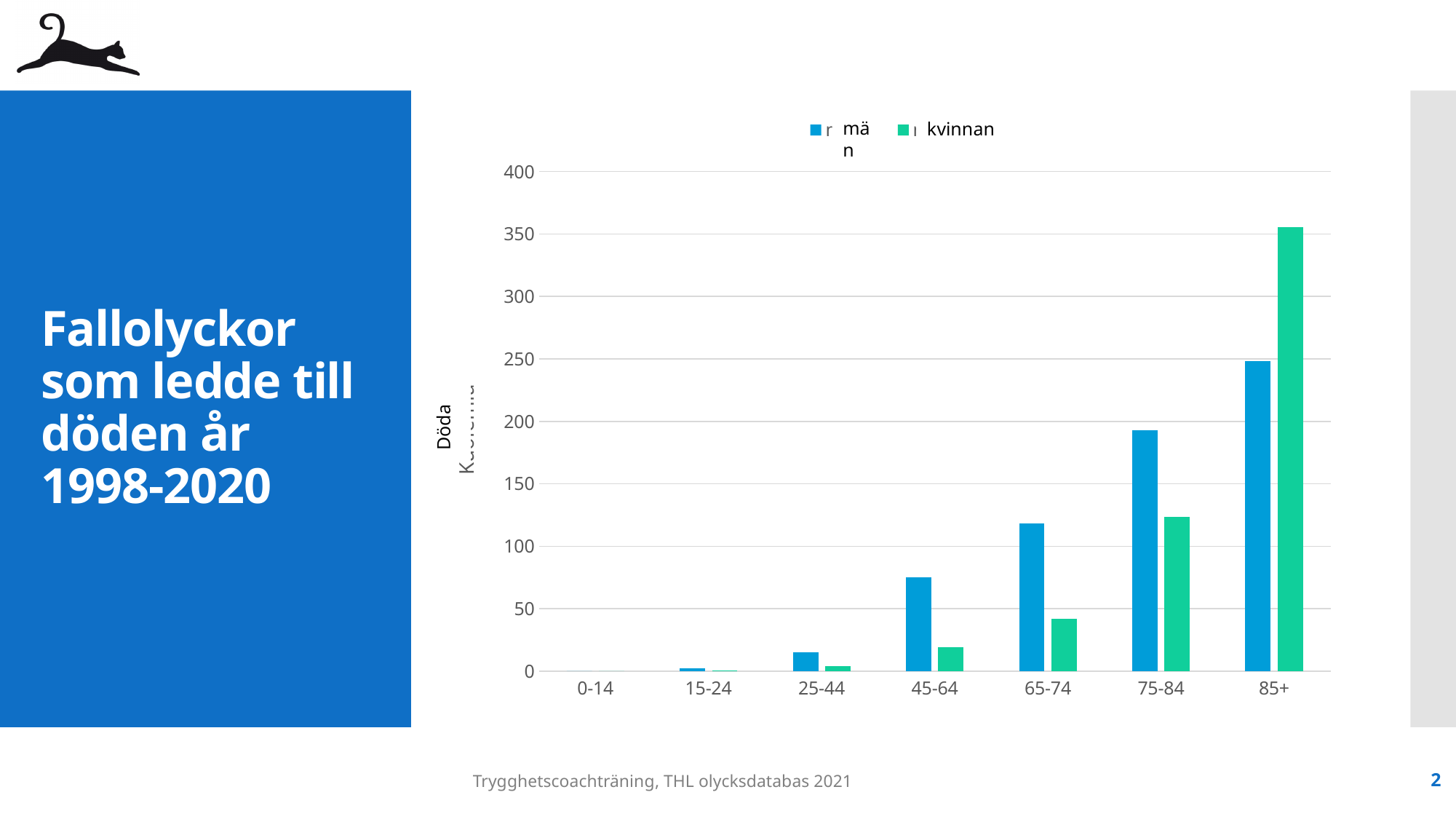
Which series are listed in the legend? män and kvinnan In the 75-84 age group, which is larger, män or kvinnan? män Which age group has the highest value for kvinnan? 85+ Do the values for kvinnan rise or fall as age increases along the x axis? rise What kind of chart is shown on the slide? bar chart Is the value for kvinnan in the 85+ age group greater or less than 300? greater In the 85+ age group, which is larger, män or kvinnan? kvinnan How many series does the legend list? 2 Is the value for män in the 75-84 age group greater or less than 150? greater Which age group has the lowest value for män? 0-14 Which age group has the highest value for män? 85+ How many age-group categories are shown on the x axis? 7